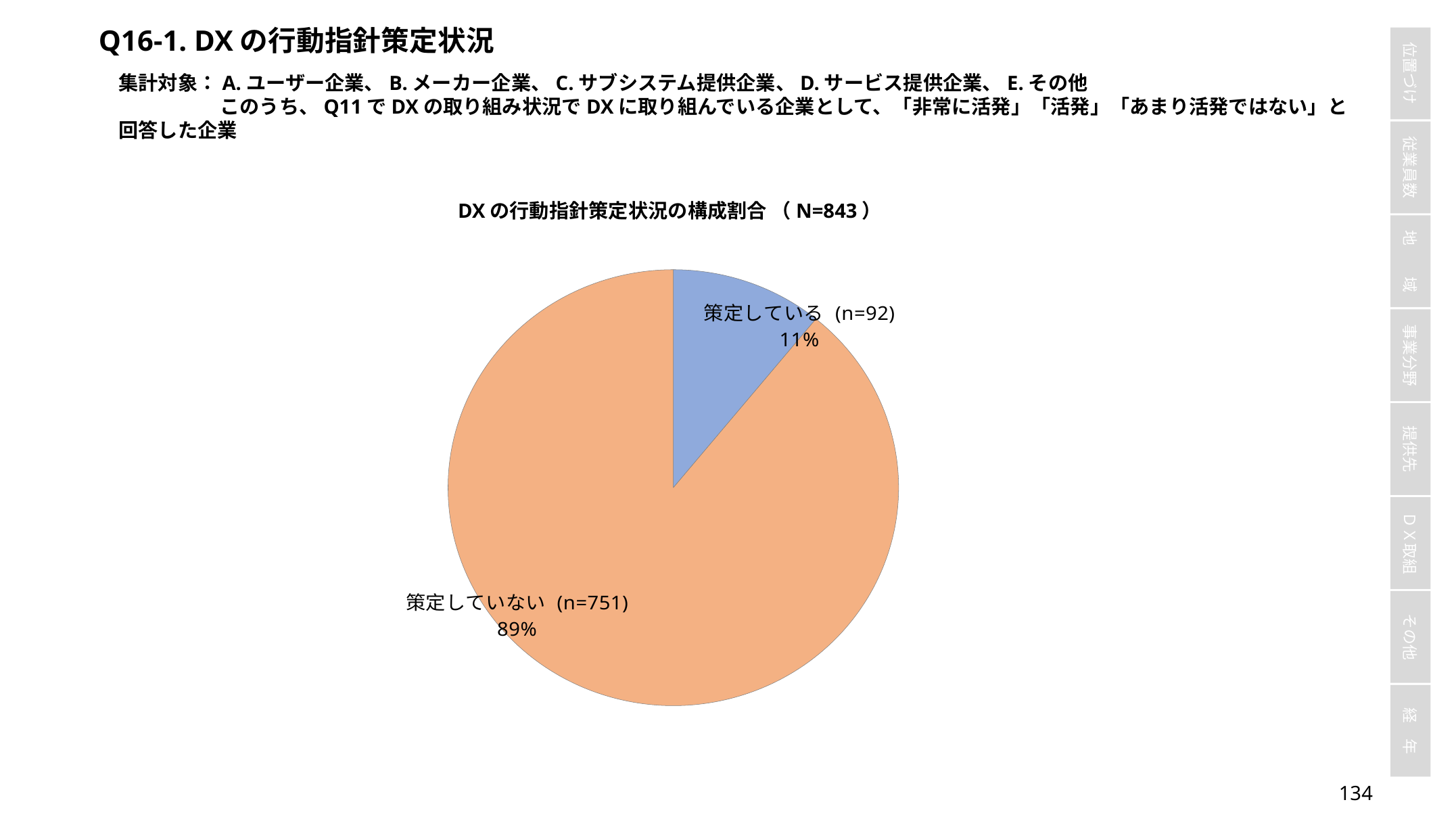
Which is larger, the share for 策定している or the share for 策定していない? 策定していない What colour is the 策定している slice? blue What percentage share does the 策定していない slice have? 89% What is the difference in percentage points between 策定していない and 策定している? 78 How many slices does the pie chart have? 2 Which category has the largest share of the pie? 策定していない What is the n value shown for 策定していない? n=751 Which category has the smallest share of the pie? 策定している What kind of chart is shown on the slide? pie chart What is the n value shown for 策定している? n=92 What percentage share does the 策定している slice have? 11% What is the N value given in the chart title? N=843